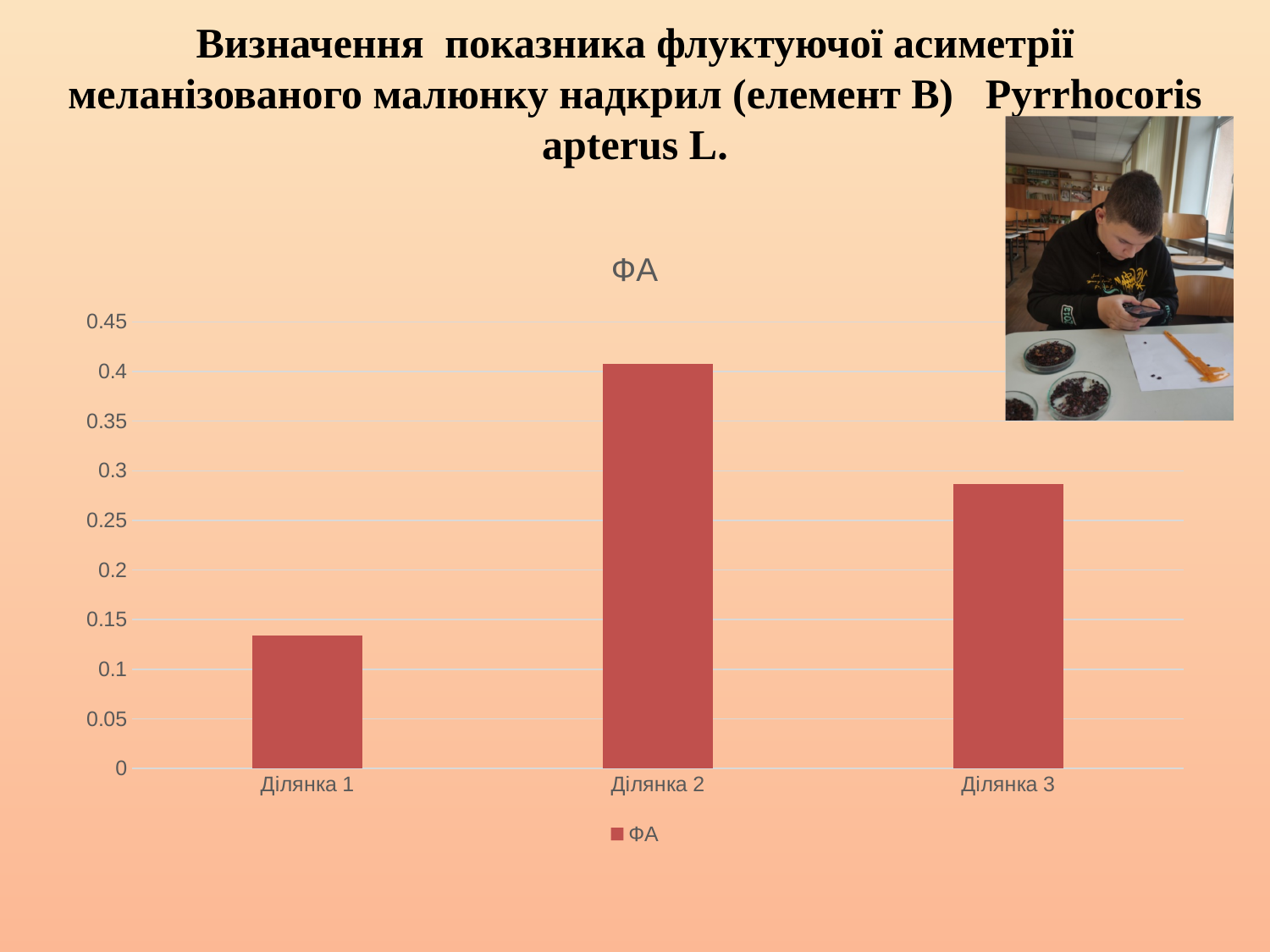
What is the title of the chart? ФА Which category has the highest value in the chart? Ділянка 2 What is the name of the series shown in the chart legend? ФА Which category has the lowest value in the chart? Ділянка 1 What kind of chart is shown on the slide? bar chart Which is larger, the value for Ділянка 2 or the value for Ділянка 3? Ділянка 2 Is the value for Ділянка 2 greater or less than 0.35? greater Is the value for Ділянка 3 greater or less than 0.3? less How many categories are shown on the x axis of the chart? 3 How many series does the chart legend list? 1 Is the value for Ділянка 1 greater or less than 0.15? less Which is larger, the value for Ділянка 1 or the value for Ділянка 3? Ділянка 3